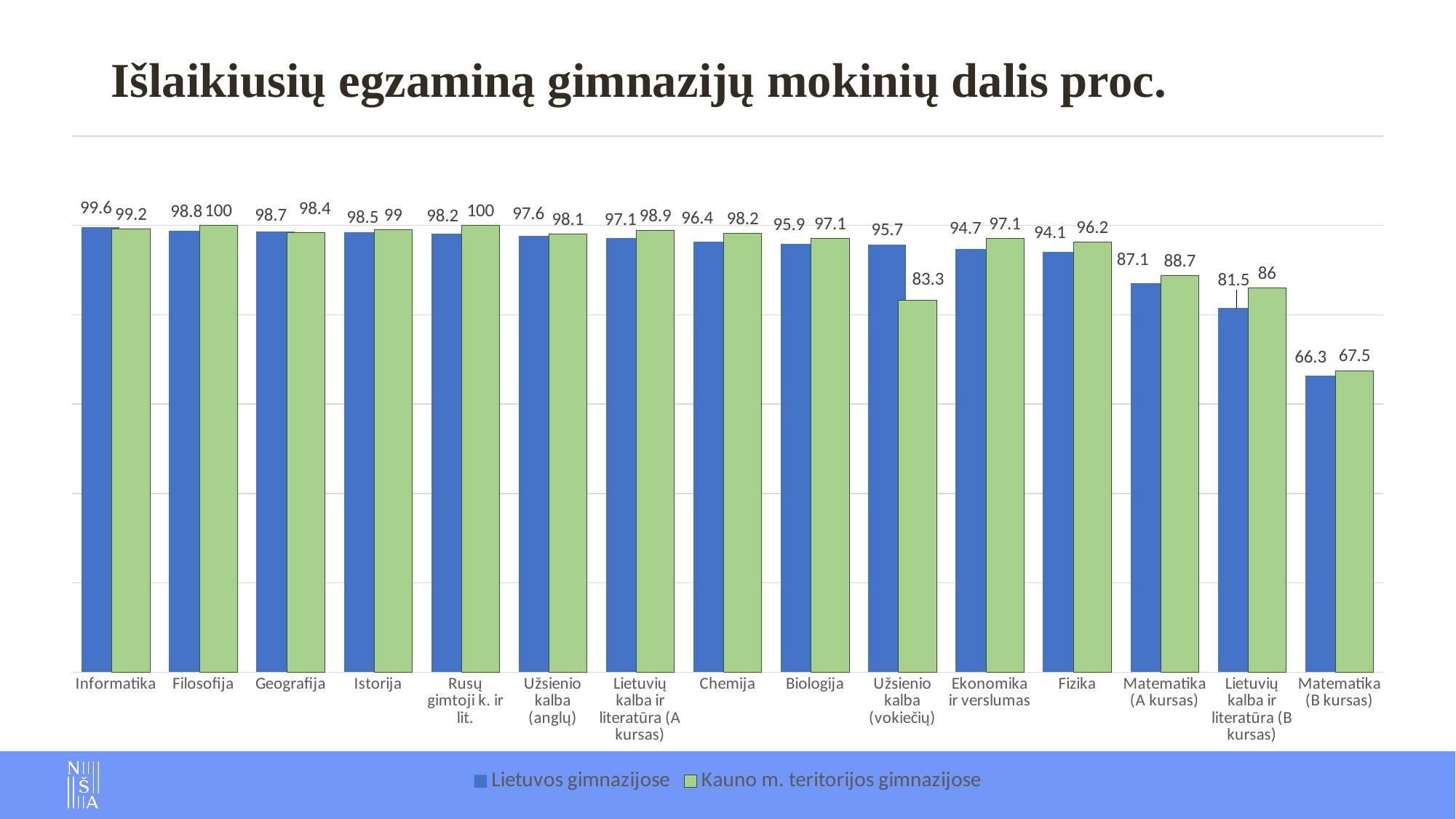
What is the value for Lietuvos gimnazijose in Matematika (A kursas)? 87.1 Which category has the lowest value for Kauno m. teritorijos gimnazijose? Matematika (B kursas) Which is larger for Fizika: Lietuvos gimnazijose or Kauno m. teritorijos gimnazijose? Kauno m. teritorijos gimnazijose How many categories are shown on the x axis? 15 What kind of chart is shown on the slide? Bar chart How many series does the legend list? 2 What is the value for Lietuvos gimnazijose in Chemija? 96.4 Do the Lietuvos gimnazijose values rise or fall from left to right along the x axis? Fall What is the value for Kauno m. teritorijos gimnazijose in Užsienio kalba (vokiečių)? 83.3 Which category has the highest value for Lietuvos gimnazijose? Informatika What is the difference between the Lietuvos gimnazijose and Kauno m. teritorijos gimnazijose values for Užsienio kalba (vokiečių)? 12.4 What is the difference between the Kauno m. teritorijos gimnazijose and Lietuvos gimnazijose values for Lietuvių kalba ir literatūra (B kursas)? 4.5